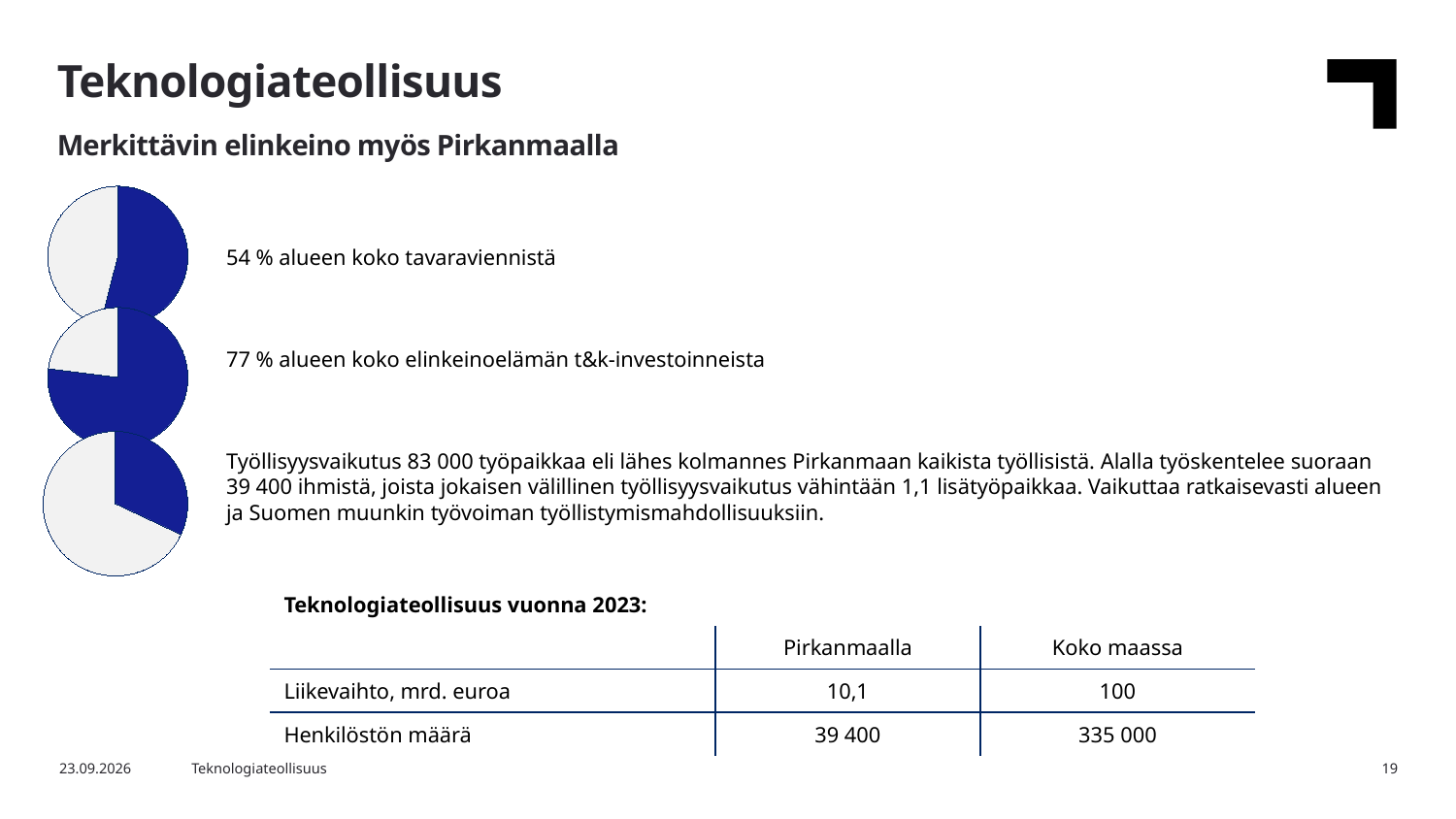
Is the blue slice larger in the top pie chart or in the bottom pie chart? Top Is the blue slice in the bottom pie chart greater or less than 50% of the pie? less What is the difference in percentage points between the shares shown for the middle pie chart (77 %) and the top pie chart (54 %)? 23 percentage points How many pie charts are on the slide? 3 Is the blue slice larger in the top pie chart or in the middle pie chart? Middle What colour is used for the highlighted slice in each of the pie charts? Blue Which pie chart has the smallest blue slice: the top, middle or bottom one? Bottom In the middle pie chart, what share of the region's business R&D investments does the blue slice represent, according to the text beside it? 77 % Which pie chart has the largest blue slice: the top, middle or bottom one? Middle What kind of charts are shown on the left side of the slide? Pie charts In the top pie chart, what share of the region's total goods exports does the blue slice represent, according to the text beside it? 54 % Is the blue slice in the middle pie chart greater or less than 50% of the pie? greater